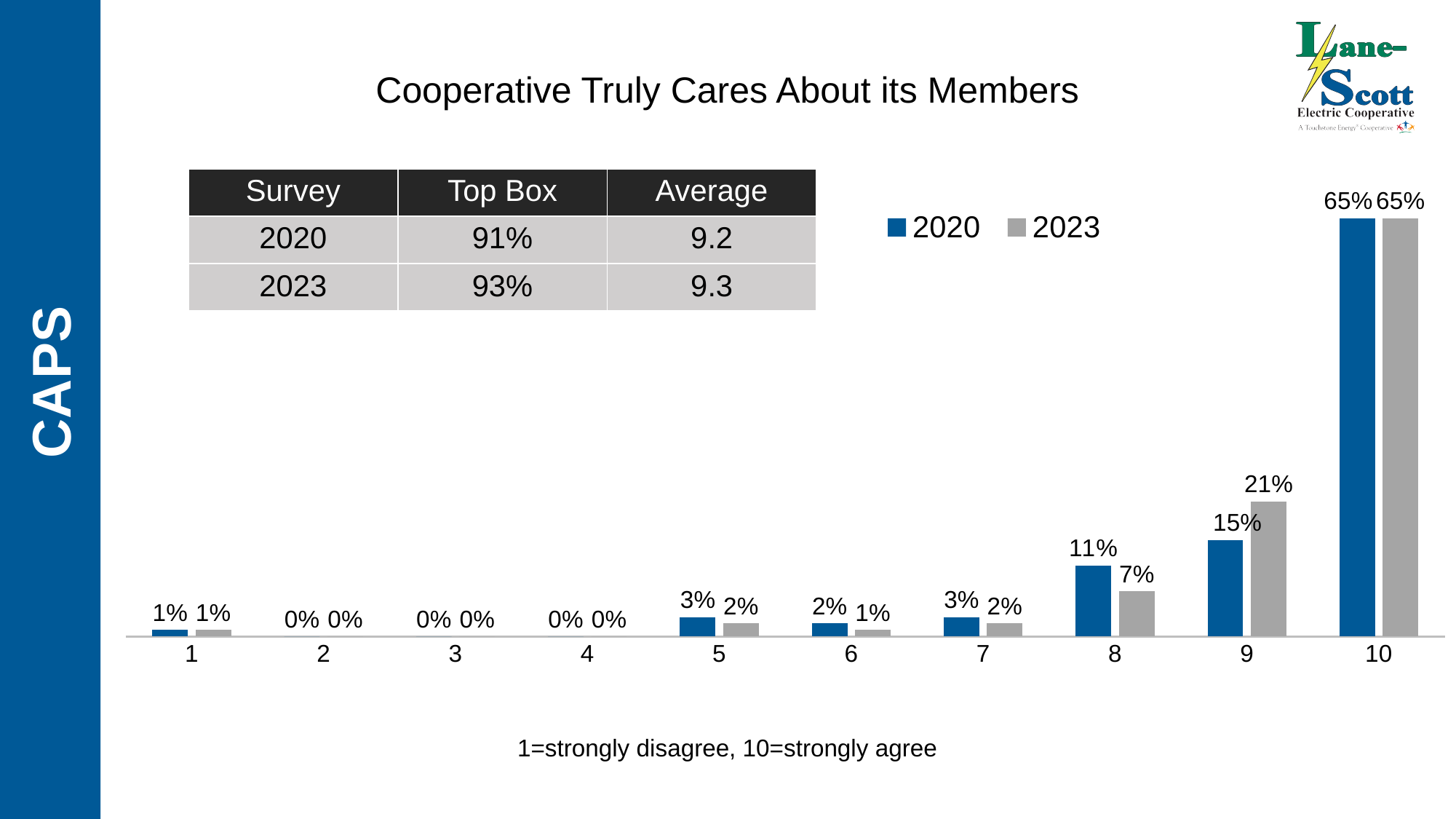
Which rating category has the highest value for the 2023 series? 10 How many rating categories are shown on the x axis? 10 What is the 2020 value for rating 10? 65% What is the title of the chart? Cooperative Truly Cares About its Members Which is larger for rating 9: the 2020 value or the 2023 value? 2023 What kind of chart is shown on the slide? Bar chart What is the 2020 value for rating 8? 11% How many series does the legend list? 2 What is the difference between the 2020 and 2023 values for rating 8? 4% What is the 2023 value for rating 5? 2% What is the 2023 value for rating 9? 21% What is the difference between the 2023 and 2020 values for rating 9? 6%